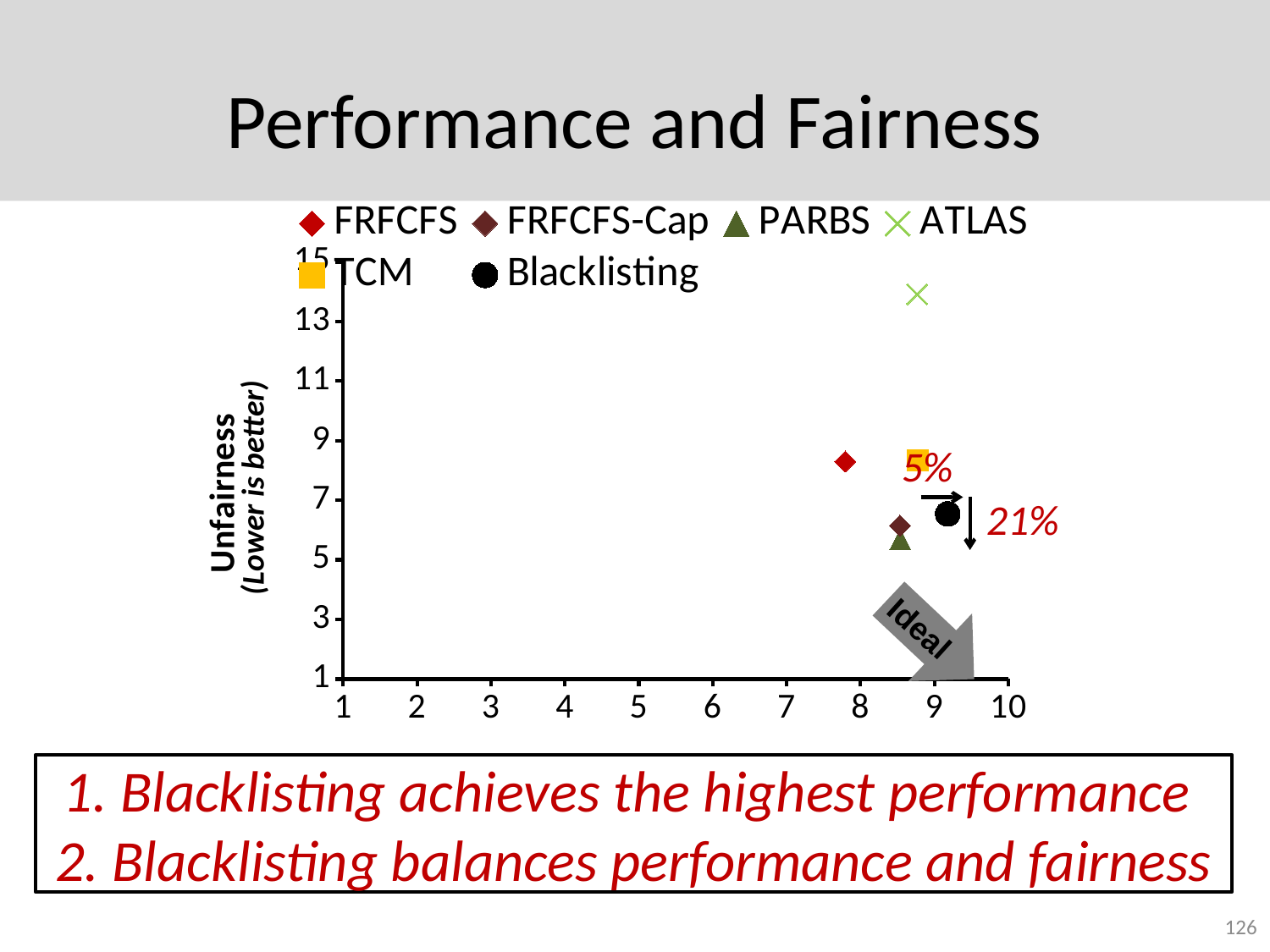
What marker shape represents Blacklisting in the legend? black circle Which has the higher unfairness value, ATLAS or FRFCFS? ATLAS Is the unfairness value for ATLAS greater or less than 13? greater Which series has the highest unfairness value? ATLAS Is the unfairness value for PARBS greater or less than 7? less Which has the higher unfairness value, FRFCFS or Blacklisting? FRFCFS Is the unfairness value for FRFCFS greater or less than 7? greater What is the label of the y axis? Unfairness (Lower is better) How many series does the legend list? 6 Which series is plotted furthest to the right on the x axis? Blacklisting What kind of chart is shown on the slide? scatter chart